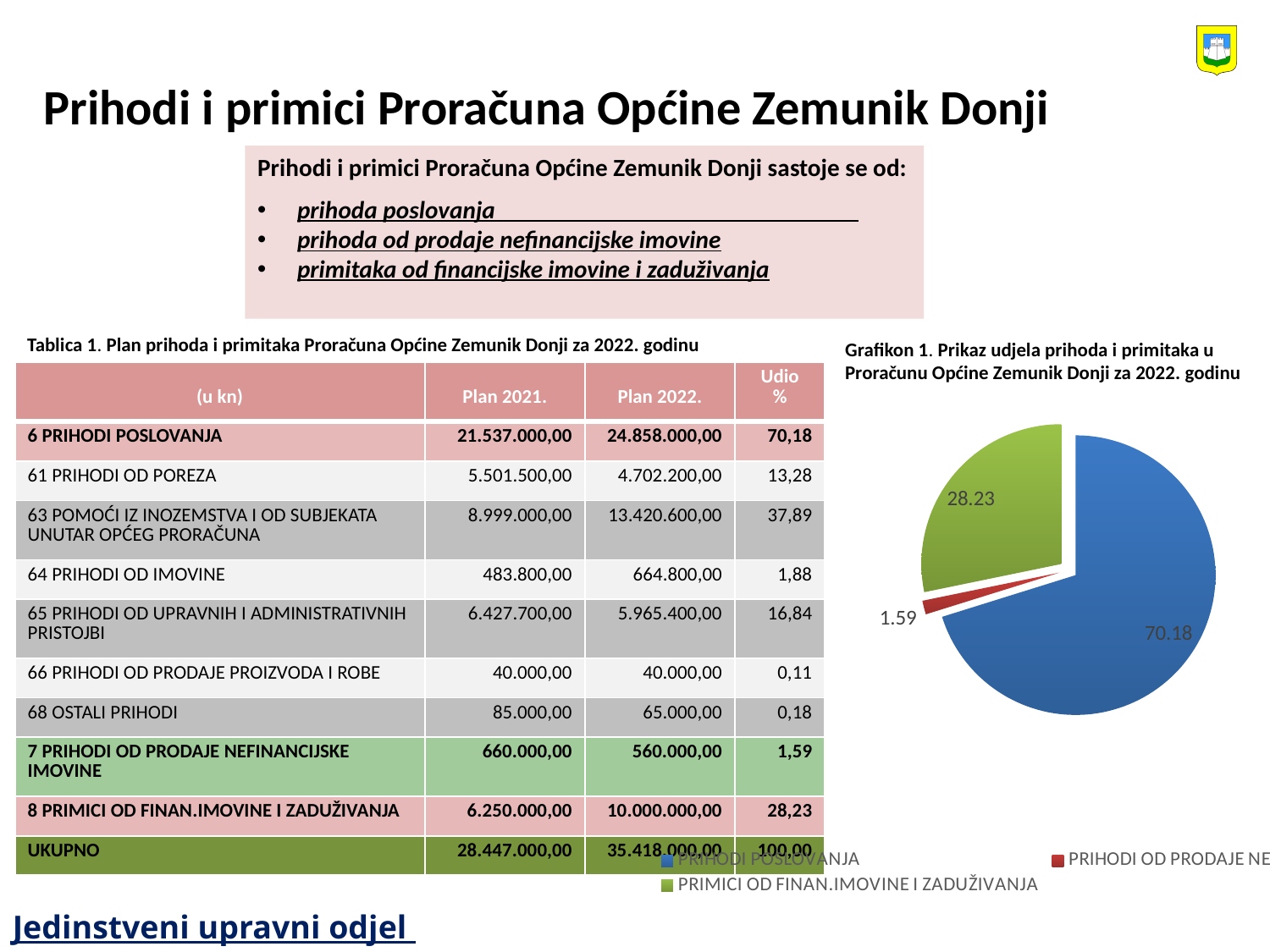
How many entries does the legend of the pie chart list? 3 What kind of chart is Grafikon 1 on the slide? pie chart What is the difference between the pie chart values for PRIHODI POSLOVANJA and PRIMICI OD FINAN.IMOVINE I ZADUŽIVANJA? 41.95 What value is shown on the pie chart for PRIMICI OD FINAN.IMOVINE I ZADUŽIVANJA? 28.23 In the pie chart, which is larger: PRIHODI POSLOVANJA or PRIMICI OD FINAN.IMOVINE I ZADUŽIVANJA? PRIHODI POSLOVANJA Is the pie chart value for PRIMICI OD FINAN.IMOVINE I ZADUŽIVANJA greater or less than 50? less What is the title of the pie chart? Grafikon 1. Prikaz udjela prihoda i primitaka u Proračunu Općine Zemunik Donji za 2022. godinu What colour is the PRIHODI POSLOVANJA slice in the pie chart? blue What is the value of the smallest slice in the pie chart? 1.59 How many slices does the pie chart have? 3 Which category has the largest slice in the pie chart? PRIHODI POSLOVANJA What value is shown on the pie chart for PRIHODI POSLOVANJA? 70.18